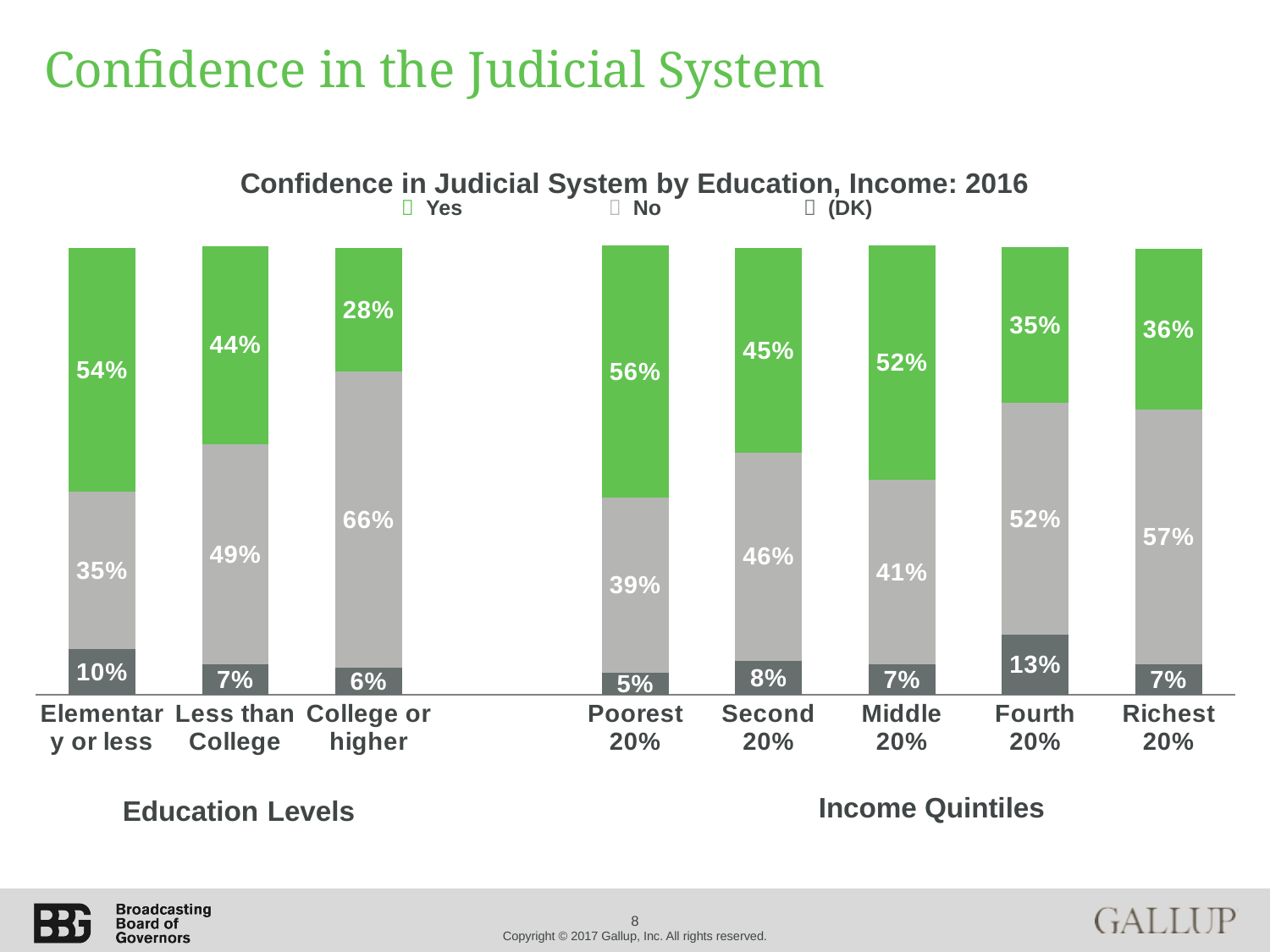
What is the difference between the 'No' values for 'College or higher' and 'Elementary or less'? 31% What is the '(DK)' value for the 'Fourth 20%' income quintile? 13% What kind of chart is shown on the slide? Stacked bar chart How many series does the legend list? 3 How many categories are shown on the x axis in total across both groups? 8 What is the 'No' value for the 'Poorest 20%' income quintile? 39% Among the education levels, which category has the highest 'Yes' value? Elementary or less Which is larger: the 'Yes' value for 'Middle 20%' or the 'Yes' value for 'Richest 20%'? Middle 20% Among the income quintiles, which category has the lowest '(DK)' value? Poorest 20% Across the education levels from 'Elementary or less' to 'College or higher', does the 'Yes' value rise or fall? Fall What is the title of the chart? Confidence in Judicial System by Education, Income: 2016 What percentage of respondents with 'College or higher' education answered 'Yes' to having confidence in the judicial system? 28%